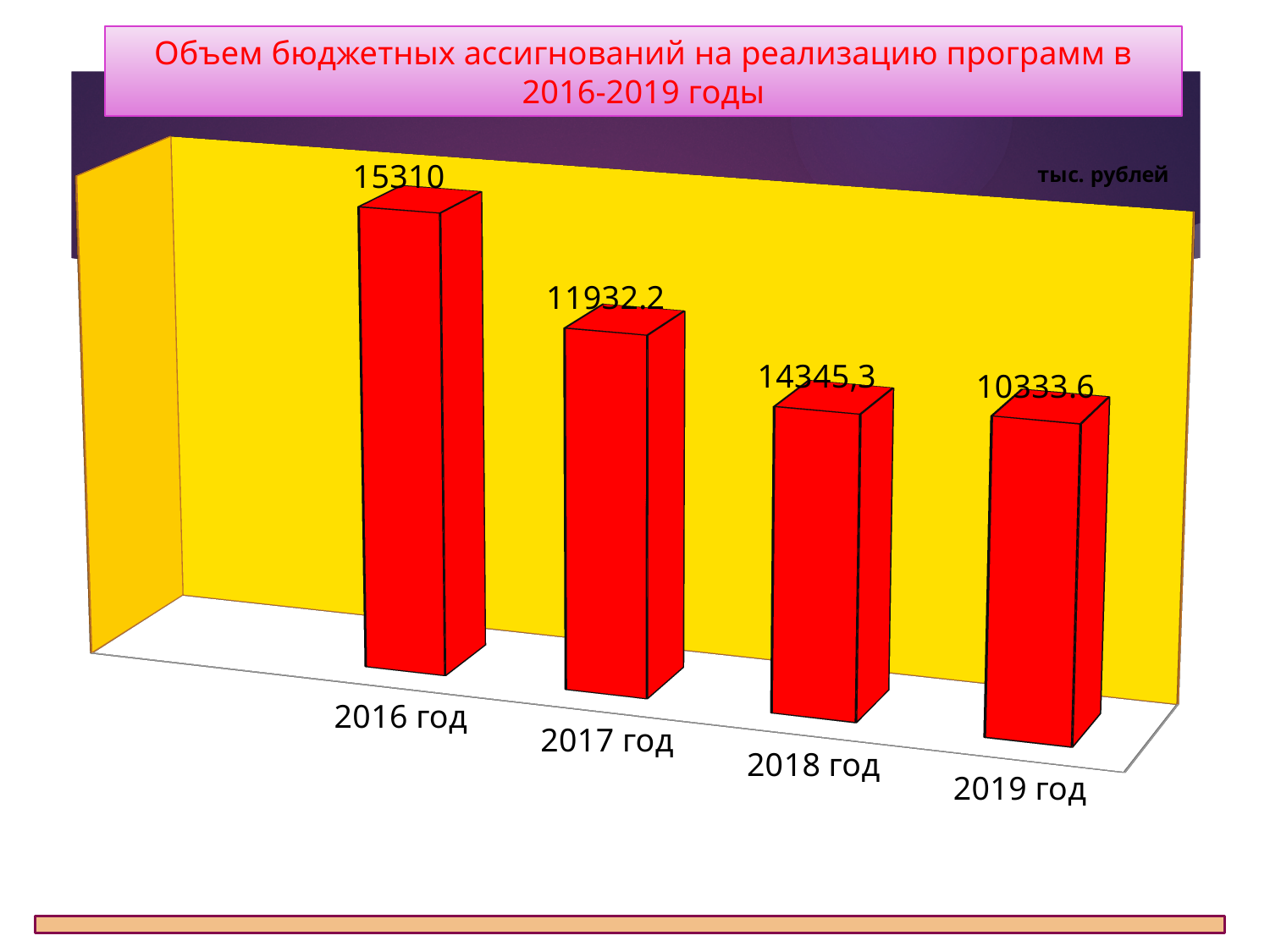
What unit is indicated for the values on the chart? тыс. рублей How many years are shown on the chart? 4 Which is larger, the value for 2016 год or the value for 2019 год? 2016 год What is the value for 2018 год? 14345,3 What is the value for 2016 год? 15310 What is the value for 2019 год? 10333.6 What kind of chart is shown on the slide? bar chart What is the difference between the values for 2016 год and 2019 год? 4976.4 Which year has the highest value? 2016 год What is the difference between the values for 2016 год and 2017 год? 3377.8 What is the value for 2017 год? 11932.2